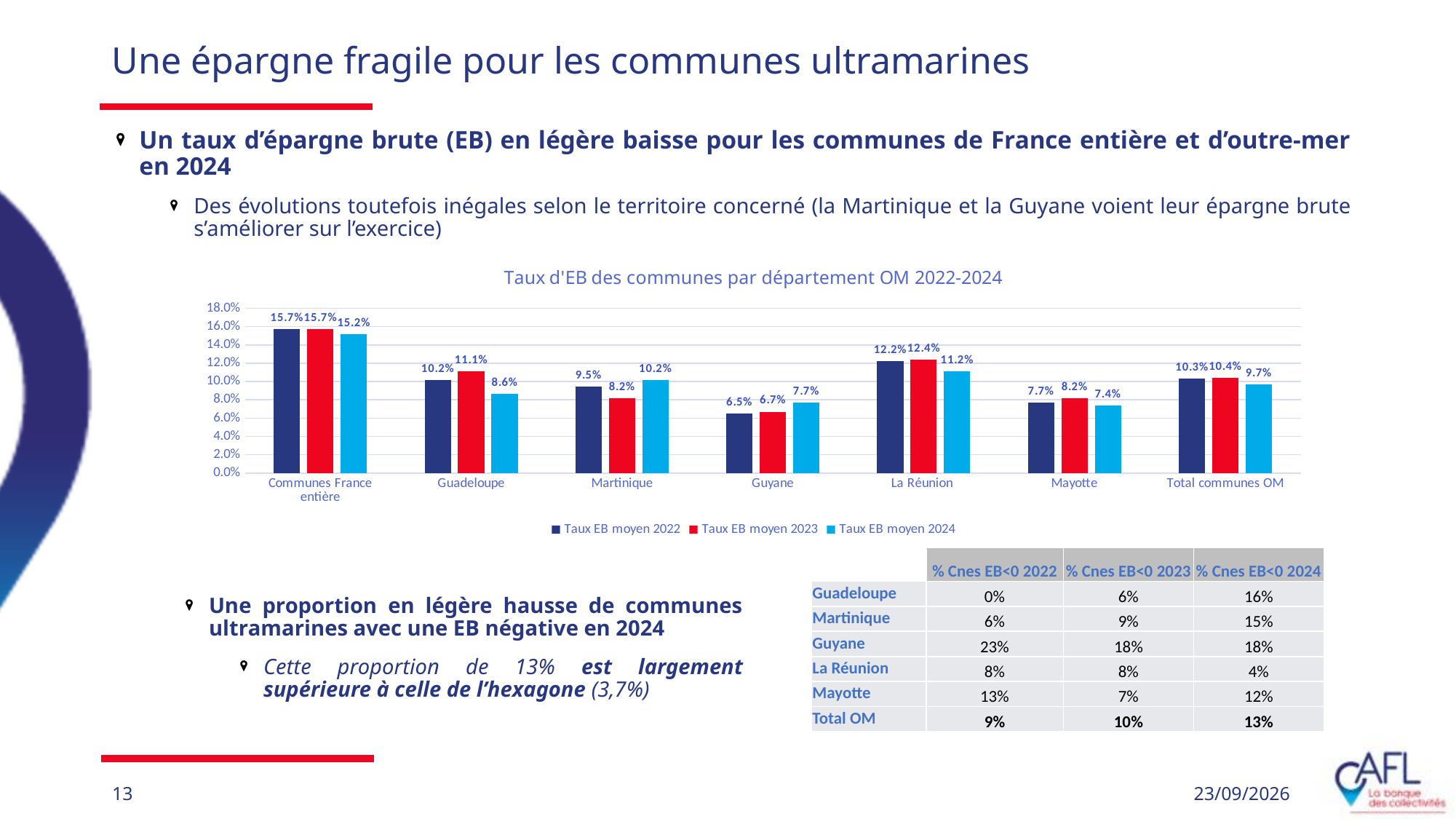
What is the Taux EB moyen 2022 for La Réunion? 12.2% Which category has the highest Taux EB moyen 2024? Communes France entière What is the Taux EB moyen 2023 for Mayotte? 8.2% How many categories are shown on the x axis of the chart? 7 For Guyane, do the values rise or fall from 2022 to 2024? rise How many series does the chart legend list? 3 What is the difference between the Taux EB moyen 2023 and the Taux EB moyen 2024 for Guadeloupe? 2.5% Which is larger for Martinique: the Taux EB moyen 2022 or the Taux EB moyen 2024? Taux EB moyen 2024 What type of chart is shown on the slide? bar chart What is the title of the chart? Taux d'EB des communes par département OM 2022-2024 Which category has the lowest Taux EB moyen 2022? Guyane What is the Taux EB moyen 2024 for Guadeloupe? 8.6%